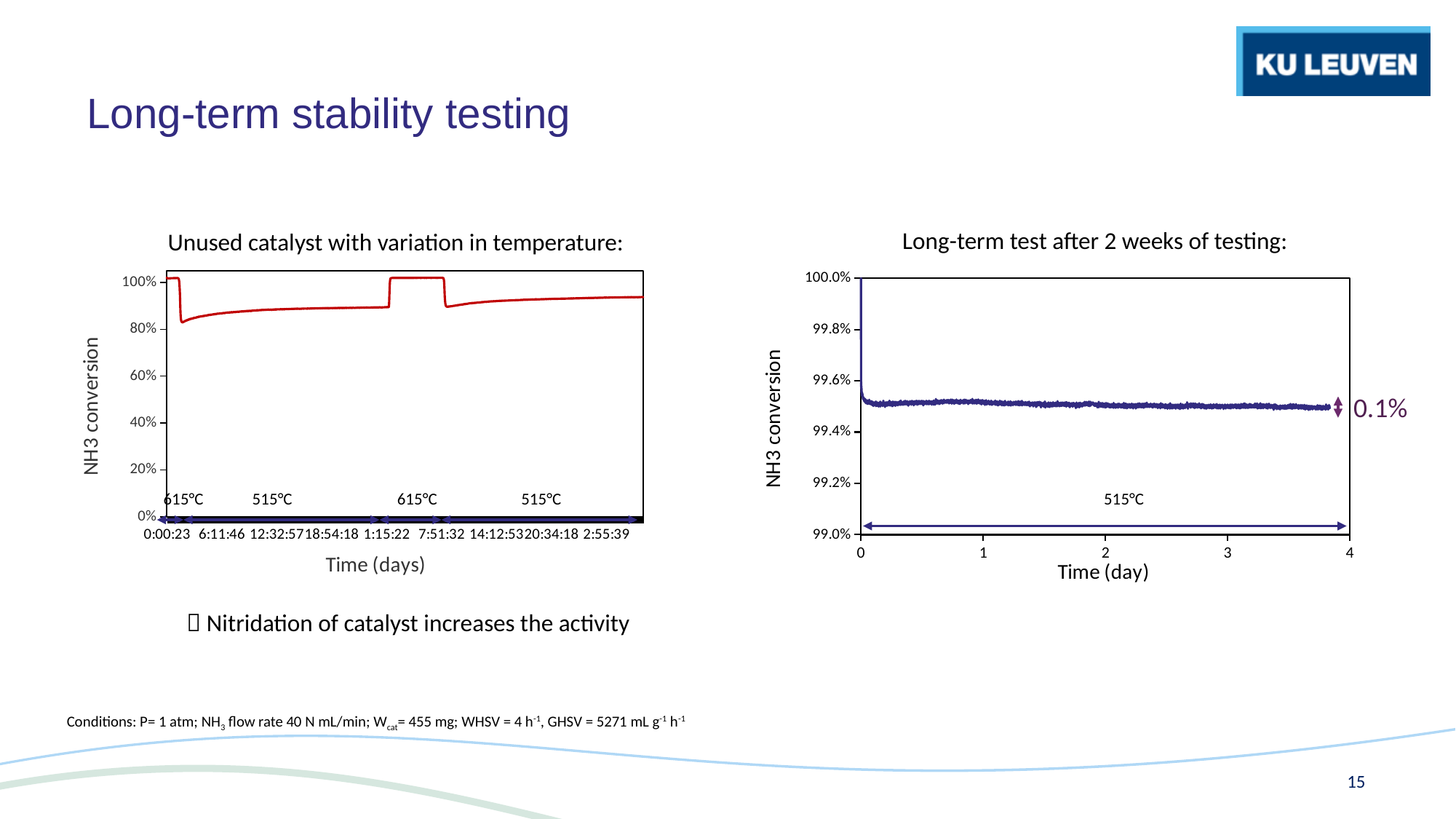
In the left chart, is the NH3 conversion during the first 515°C period greater or less than 60%? greater In the left chart, is the NH3 conversion during the second 615°C period greater or less than 80%? greater In the left chart, how many temperature labels are shown along the bottom of the plot? 4 In the right chart, what is the highest value shown on the y-axis? 100.0% In the left chart, does the NH3 conversion rise or fall over the course of the final 515°C period? rise In the right chart, what is the largest value shown on the x-axis? 4 What kind of chart is the 'Unused catalyst with variation in temperature' chart on the left? line chart In the right chart, is the NH3 conversion at day 3 greater or less than 99.4%? greater What kind of chart is the 'Long-term test after 2 weeks of testing' chart on the right? line chart In the right chart, what is the x-axis title? Time (day) In the left chart, what is the y-axis title? NH3 conversion